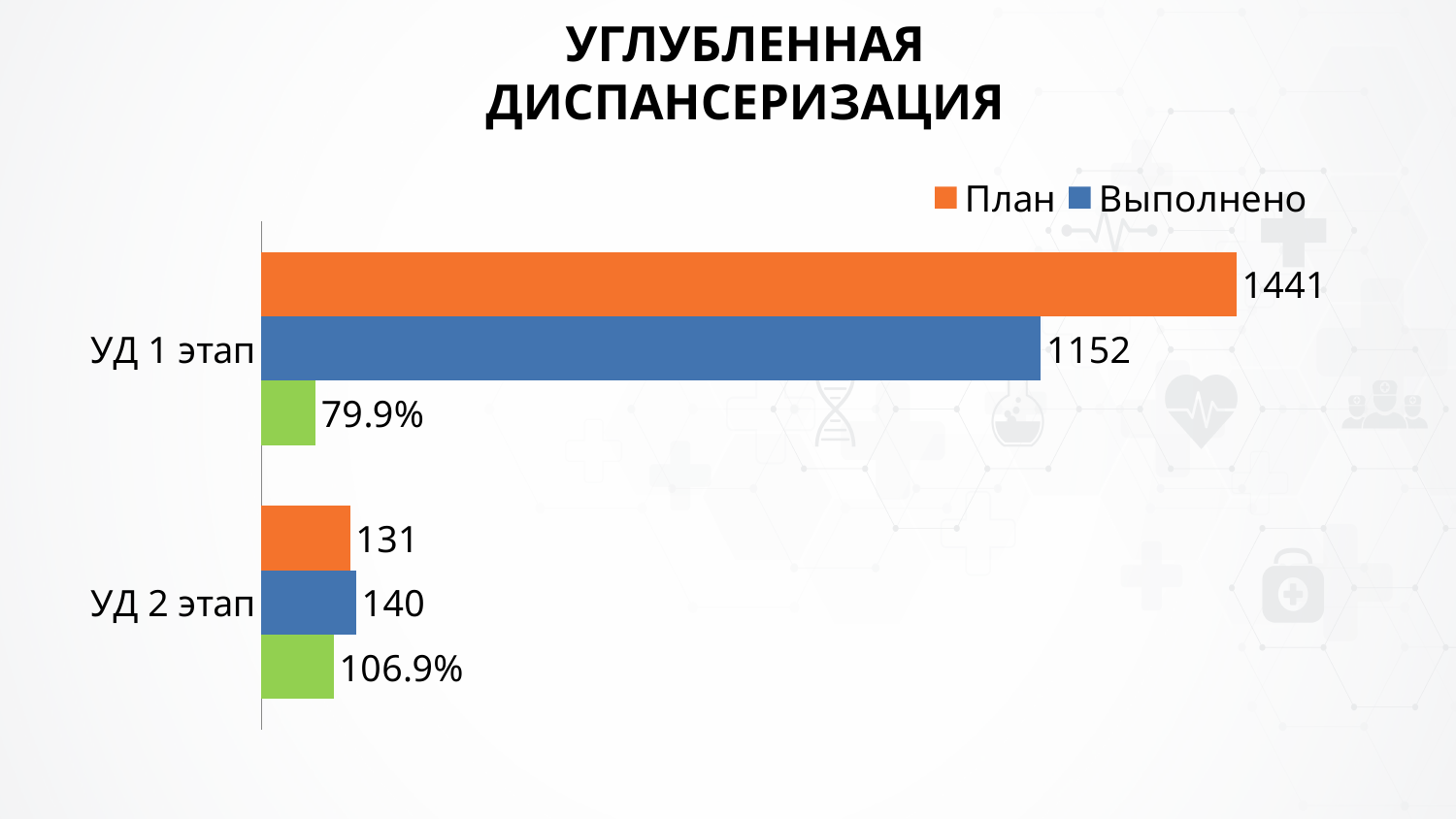
Which category has the higher План value? УД 1 этап How many series does the legend list? 2 What is the План value for УД 2 этап? 131 What is the Выполнено value for УД 2 этап? 140 What is the difference between План and Выполнено for УД 1 этап? 289 What type of chart is shown on the slide? Bar chart How many categories are shown on the chart? 2 What percentage is shown on the green bar for УД 1 этап? 79.9% What percentage is shown on the green bar for УД 2 этап? 106.9% For УД 2 этап, which is larger: План or Выполнено? Выполнено What is the План value for УД 1 этап? 1441 What is the Выполнено value for УД 1 этап? 1152